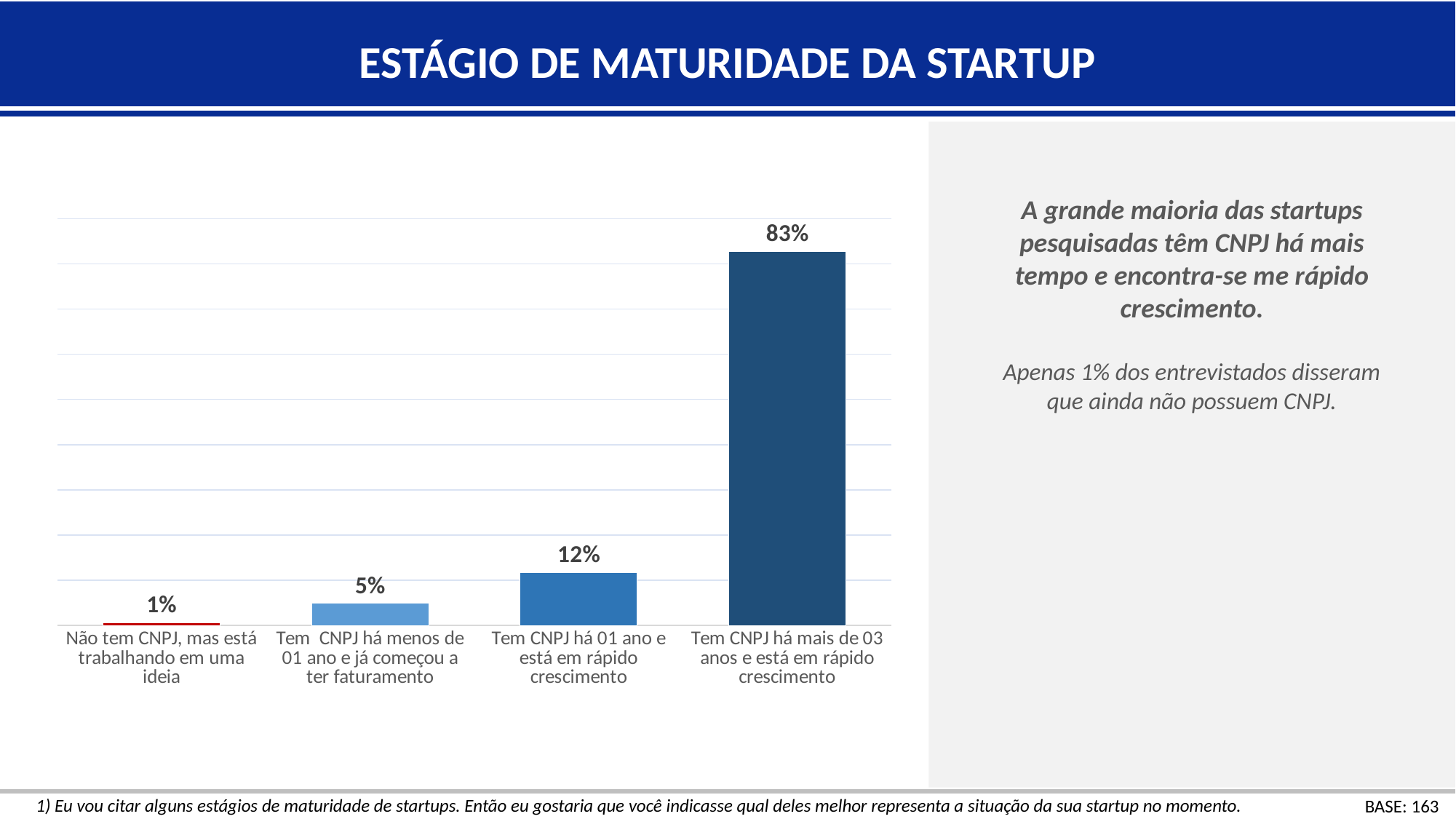
What is the value for 'Não tem CNPJ, mas está trabalhando em uma ideia'? 1% What kind of chart is shown on the slide? Bar chart Which is larger: the value for 'Tem CNPJ há menos de 01 ano' or 'Tem CNPJ há 01 ano'? Tem CNPJ há 01 ano e está em rápido crescimento How many categories are shown in the chart? 4 What is the value for 'Tem CNPJ há 01 ano e está em rápido crescimento'? 12% Do the values rise or fall from left to right along the x axis? Rise What percentage of startups have had a CNPJ for more than 03 years and are in rapid growth? 83% What is the value for 'Tem CNPJ há menos de 01 ano e já começou a ter faturamento'? 5% What is the difference between the values for 'Tem CNPJ há 01 ano' and 'Tem CNPJ há menos de 01 ano'? 7% Which category has the highest value? Tem CNPJ há mais de 03 anos e está em rápido crescimento Which category has the lowest value? Não tem CNPJ, mas está trabalhando em uma ideia What is the difference between the value for 'Tem CNPJ há mais de 03 anos' and 'Tem CNPJ há 01 ano'? 71%